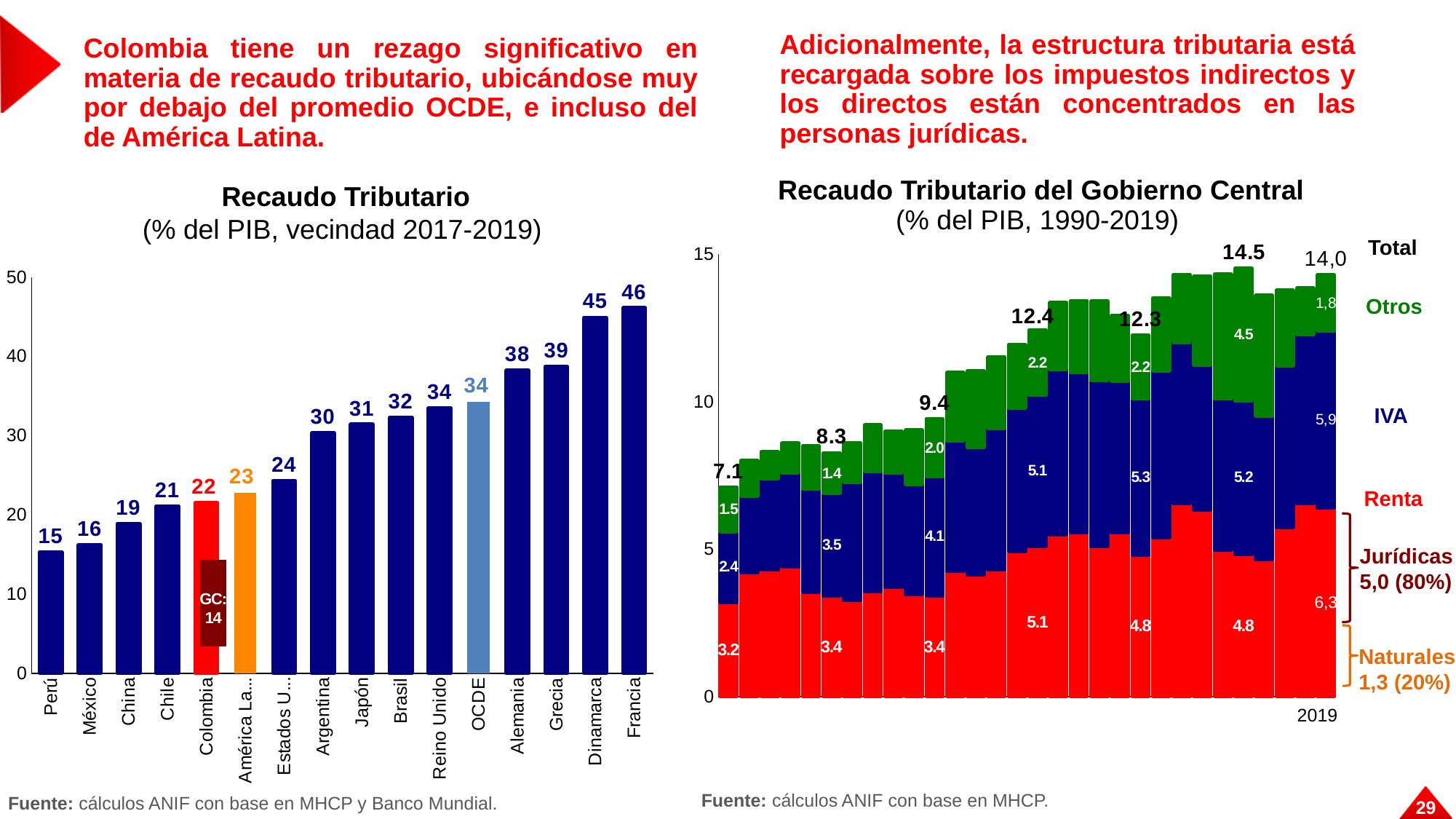
In the left chart 'Recaudo Tributario', which is larger, the value for Colombia or the value for América Latina? América Latina In the left chart 'Recaudo Tributario', what is the difference between the OCDE value and the Colombia value? 12 In the left chart 'Recaudo Tributario', which country has the highest value? Francia In the right chart 'Recaudo Tributario del Gobierno Central', what is the IVA value for 2019? 5,9 In the left chart 'Recaudo Tributario', which country has the lowest value? Perú In the left chart 'Recaudo Tributario', what is the value for Francia? 46 In the left chart 'Recaudo Tributario', what is the value for Dinamarca? 45 In the right chart 'Recaudo Tributario del Gobierno Central', what is the total value shown for 2019? 14,0 What kind of chart is the left chart 'Recaudo Tributario'? Bar chart In the right chart 'Recaudo Tributario del Gobierno Central', which is larger in 2019, Renta or IVA? Renta In the left chart 'Recaudo Tributario', how many bars are plotted? 16 In the right chart 'Recaudo Tributario del Gobierno Central', do the total values generally rise or fall from 1990 to 2019? Rise